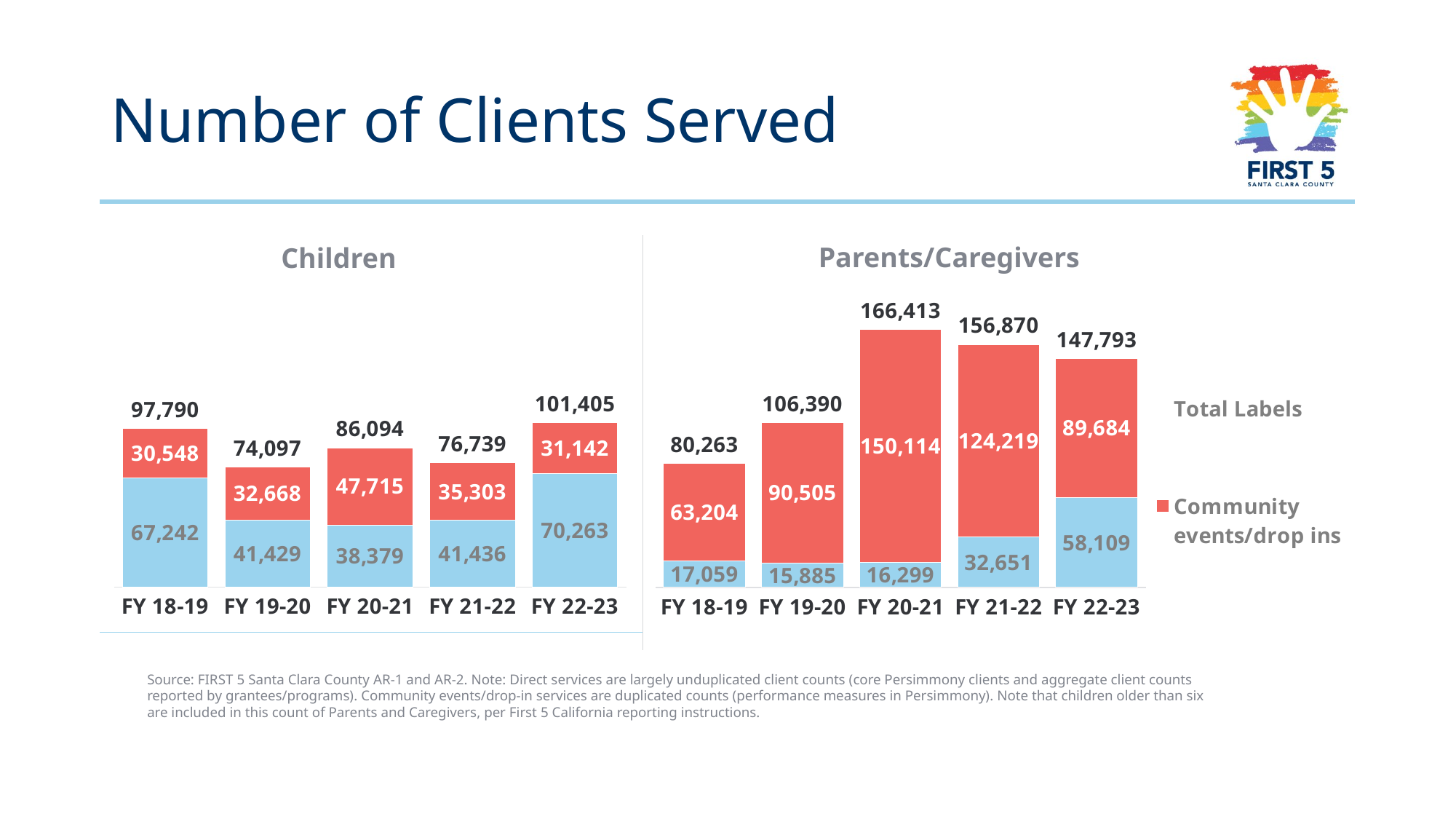
What is the title of the chart on the right side of the slide? Parents/Caregivers In the Parents/Caregivers chart, which fiscal year has the highest total? FY 20-21 In the Parents/Caregivers chart, what is the total of the stacked bar for FY 18-19? 80,263 In the Parents/Caregivers chart, does the blue bottom segment rise or fall from FY 20-21 to FY 22-23? Rise In the Parents/Caregivers chart, what is the difference between the totals for FY 20-21 and FY 21-22? 9,543 In the Children chart, which is larger: the Community events/drop ins value for FY 20-21 or for FY 21-22? FY 20-21 How many fiscal years are shown in the Parents/Caregivers chart? 5 In the Children chart, what is the value of the blue bottom segment for FY 18-19? 67,242 In the Parents/Caregivers chart, what is the Community events/drop ins value for FY 20-21? 150,114 In the Children chart, what is the total for FY 22-23? 101,405 What type of chart is the Children chart? Stacked bar chart In the Children chart, which fiscal year has the lowest total? FY 19-20